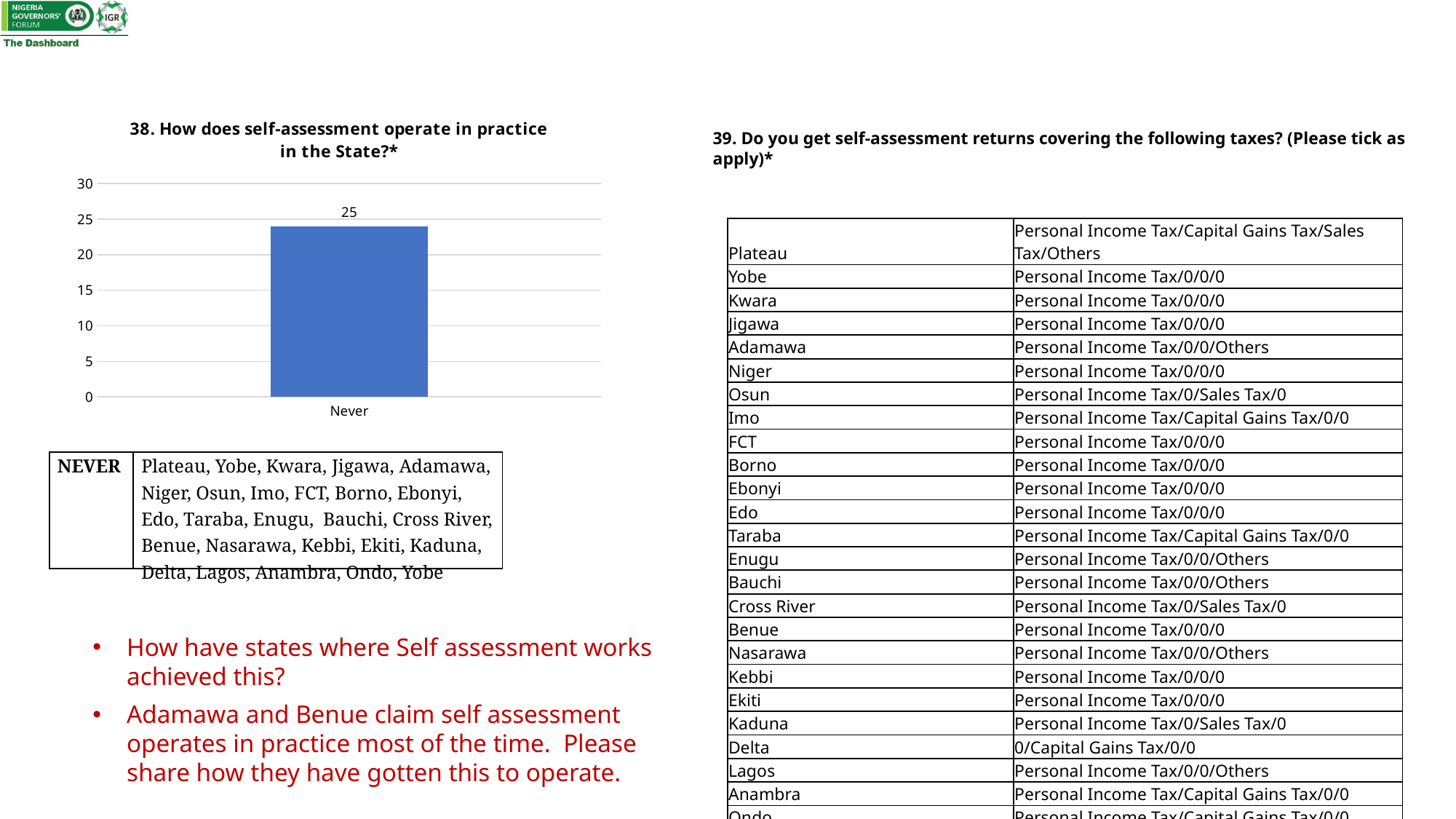
How many categories are plotted in the chart? 1 Is the value for "Never" greater or less than 20? greater What is the label of the only category on the x axis of the chart? Never What is the highest value shown on the chart's y axis? 30 What is the value of the "Never" bar in the chart? 25 Is the value for "Never" greater or less than 30? less What kind of chart is shown on the slide? bar chart What is the title of the chart? 38. How does self-assessment operate in practice in the State?*